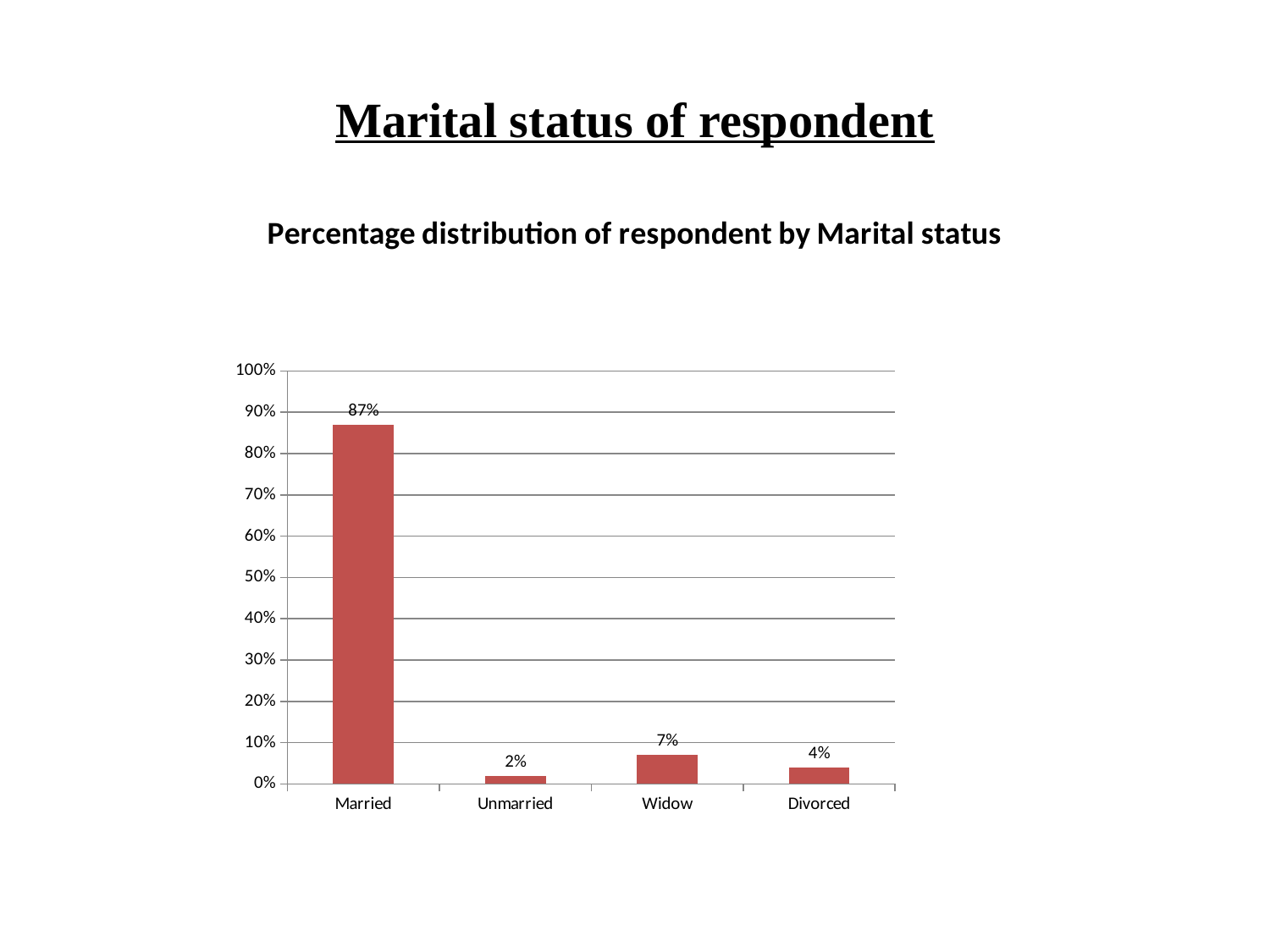
What percentage of respondents are Widow? 7% What is the difference in percentage points between Married and Widow? 80% What percentage of respondents are Married? 87% How many marital status categories are shown on the chart? 4 What is the difference in percentage points between Widow and Divorced? 3% What type of chart is shown on the slide? Bar chart What percentage of respondents are Divorced? 4% Is the value for Married greater or less than 80%? greater Which marital status category has the highest percentage? Married Which is larger, the percentage for Widow or for Divorced? Widow What percentage of respondents are Unmarried? 2% Which marital status category has the lowest percentage? Unmarried